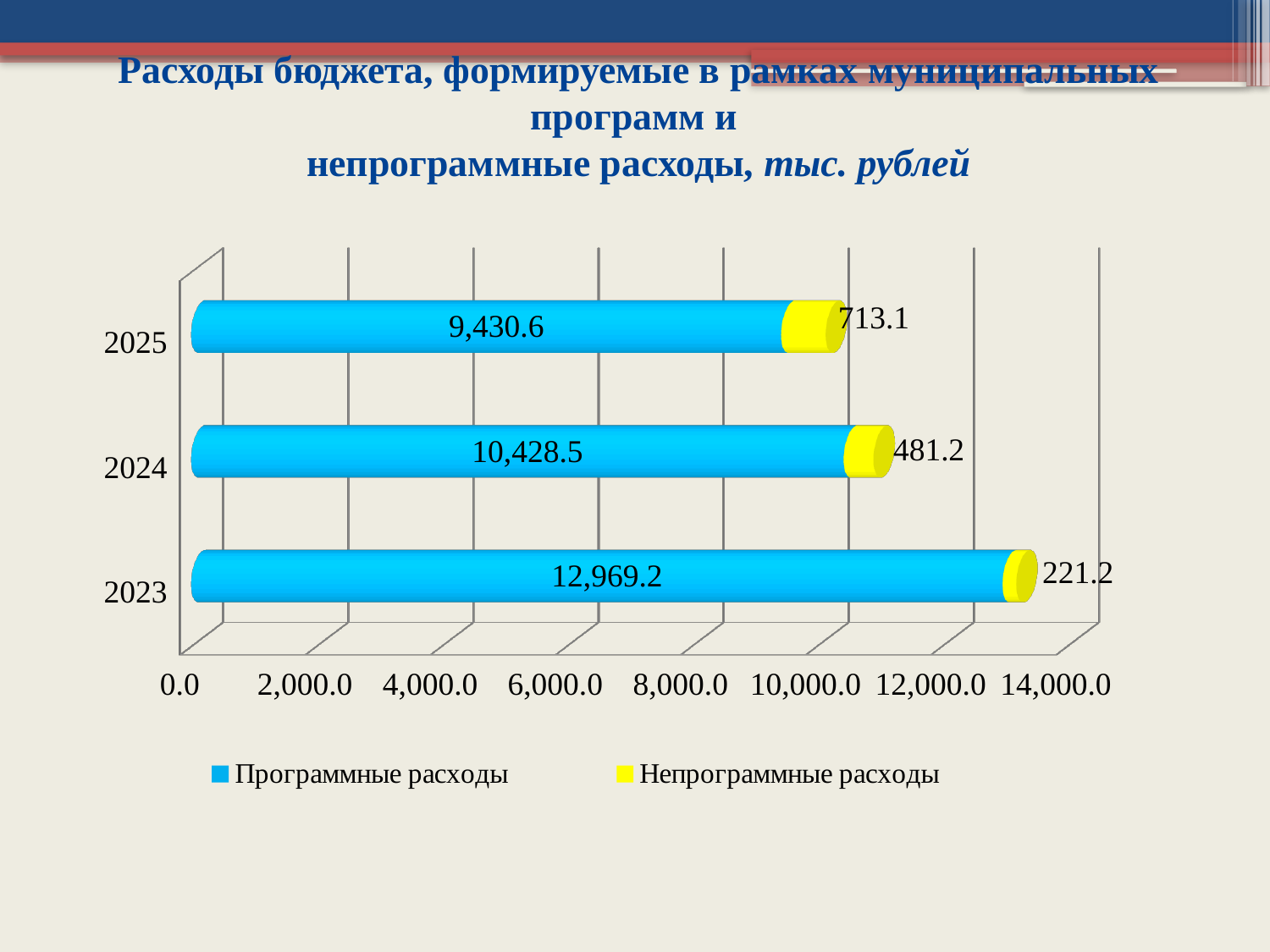
What is the value of Программные расходы for 2024? 10,428.5 Which year has the highest value of Программные расходы? 2023 What is the value of Программные расходы for 2023? 12,969.2 What is the total of the stacked bar for 2025? 10,143.7 What is the value of Непрограммные расходы for 2025? 713.1 Which is larger: Непрограммные расходы in 2024 or in 2025? 2025 What is the difference between Программные расходы in 2023 and 2024? 2,540.7 Which year has the lowest value of Непрограммные расходы? 2023 What is the total of the stacked bar for 2023? 13,190.4 What kind of chart is shown on the slide? Bar chart How many years are shown on the chart? 3 How many series does the legend list? 2